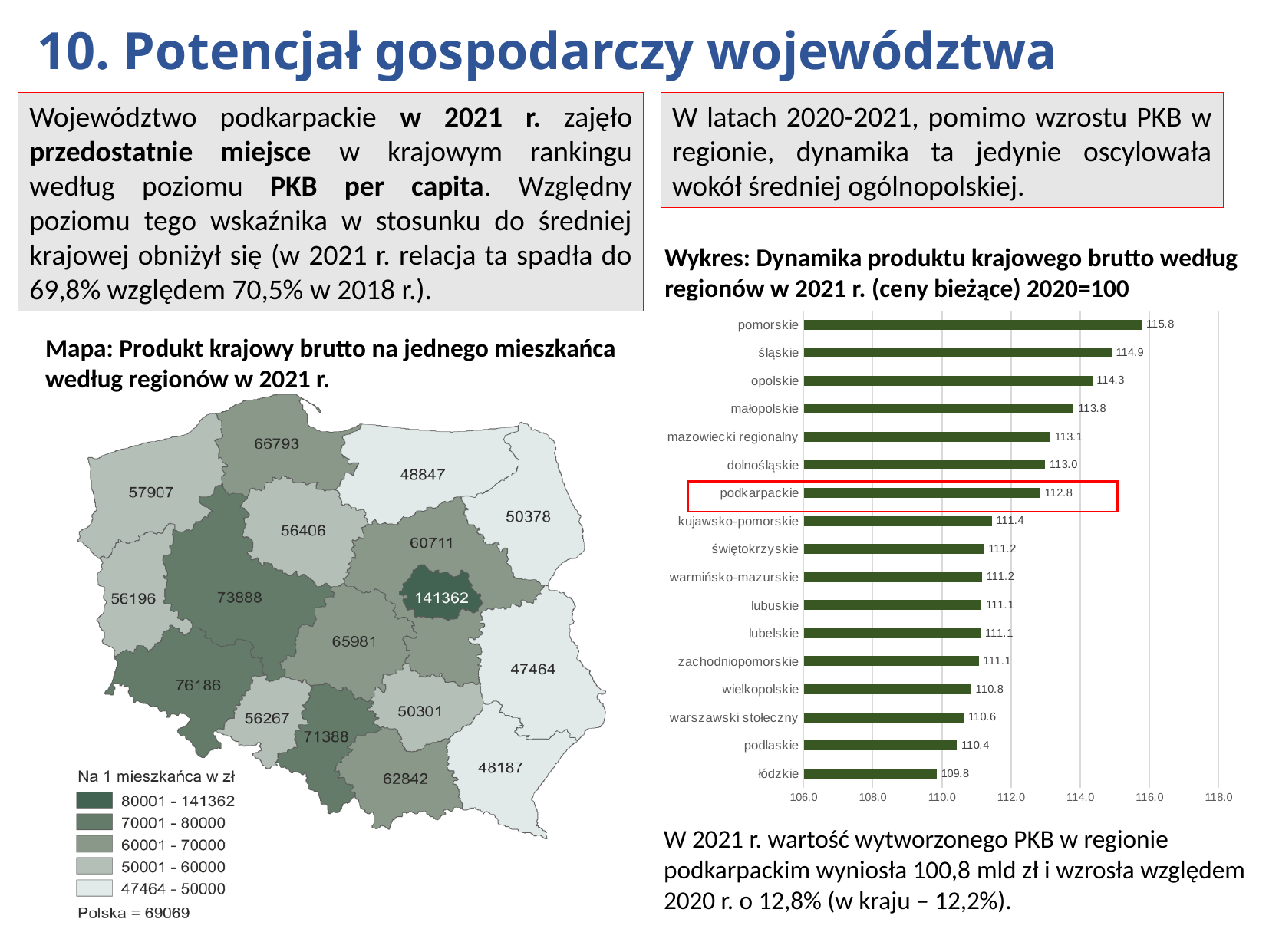
In the bar chart, what is the value for mazowiecki regionalny? 113.1 In the bar chart, which region's label is outlined with a red box? podkarpackie In the bar chart, what is the value for pomorskie? 115.8 In the bar chart, what is the value for łódzkie? 109.8 What type of chart is shown under the title 'Dynamika produktu krajowego brutto według regionów w 2021 r.'? bar chart In the bar chart, which has a larger value: opolskie or wielkopolskie? opolskie Which region has the highest value in the bar chart? pomorskie In the bar chart, what is the difference between the values for śląskie and podkarpackie? 2.1 How many regions are listed in the bar chart? 17 Which region has the lowest value in the bar chart? łódzkie In the bar chart, what is the difference between the values for pomorskie and łódzkie? 6.0 In the bar chart, what is the value for podkarpackie? 112.8